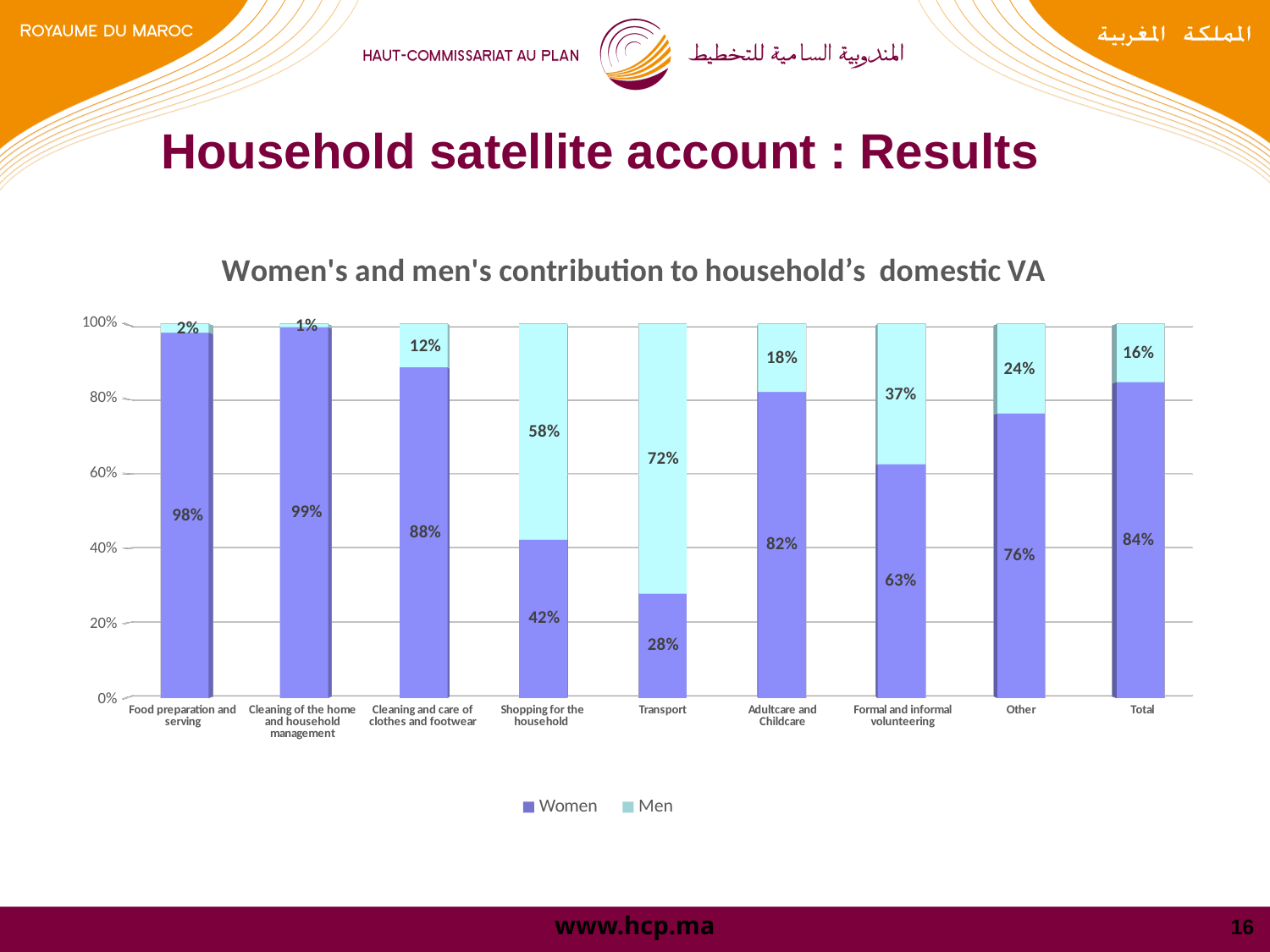
What is the Men value for Formal and informal volunteering? 37% What is the Women value for Total? 84% Which category has the highest Men value? Transport Which category has the lowest Women value? Transport What is the Women value for Transport? 28% How many categories are shown on the x axis? 9 Which category has the highest Women value? Cleaning of the home and household management What kind of chart is shown? Stacked bar chart What is the title of the chart? Women's and men's contribution to household's domestic VA How many series does the legend list? 2 Which is larger: the Men value for Shopping for the household or the Men value for Formal and informal volunteering? Shopping for the household What is the difference between the Women value for Adultcare and Childcare and the Women value for Other? 6%